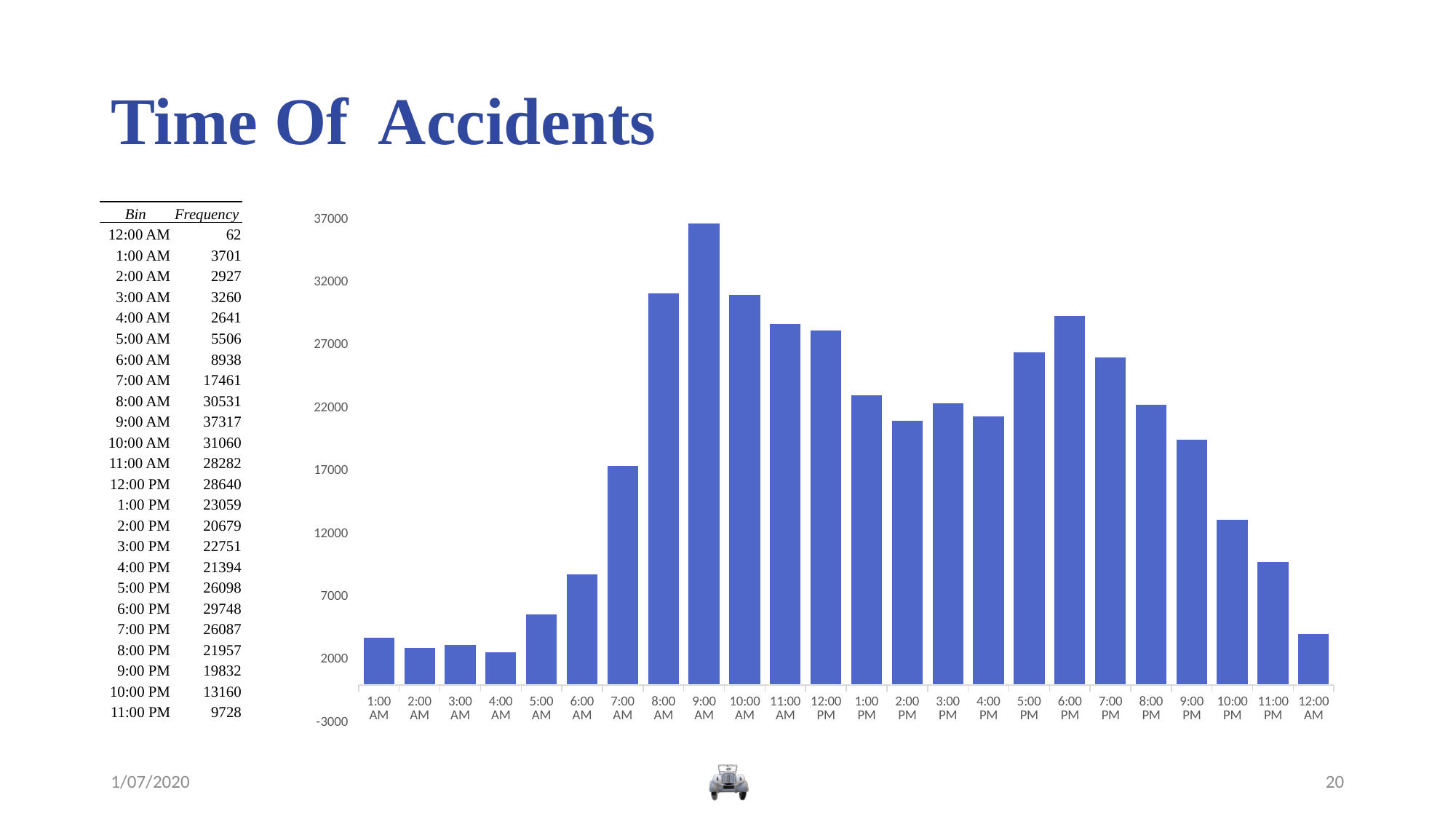
What kind of chart is shown on the slide? bar chart Which time bin has the highest frequency in the chart? 9:00 AM Which time bin has the lowest bar in the chart? 4:00 AM What is the difference between the frequency at 9:00 AM and at 8:00 AM? 6786 What is the frequency for 9:00 AM? 37317 How many bars are plotted in the chart? 24 Which has a higher frequency, 10:00 AM or 11:00 AM? 10:00 AM Is the value for 6:00 PM greater or less than 27000? greater Is the value for 9:00 PM greater or less than 22000? less What is the frequency for 8:00 AM? 30531 What is the frequency for 6:00 PM? 29748 Do the values rise or fall from 4:00 AM to 9:00 AM? rise